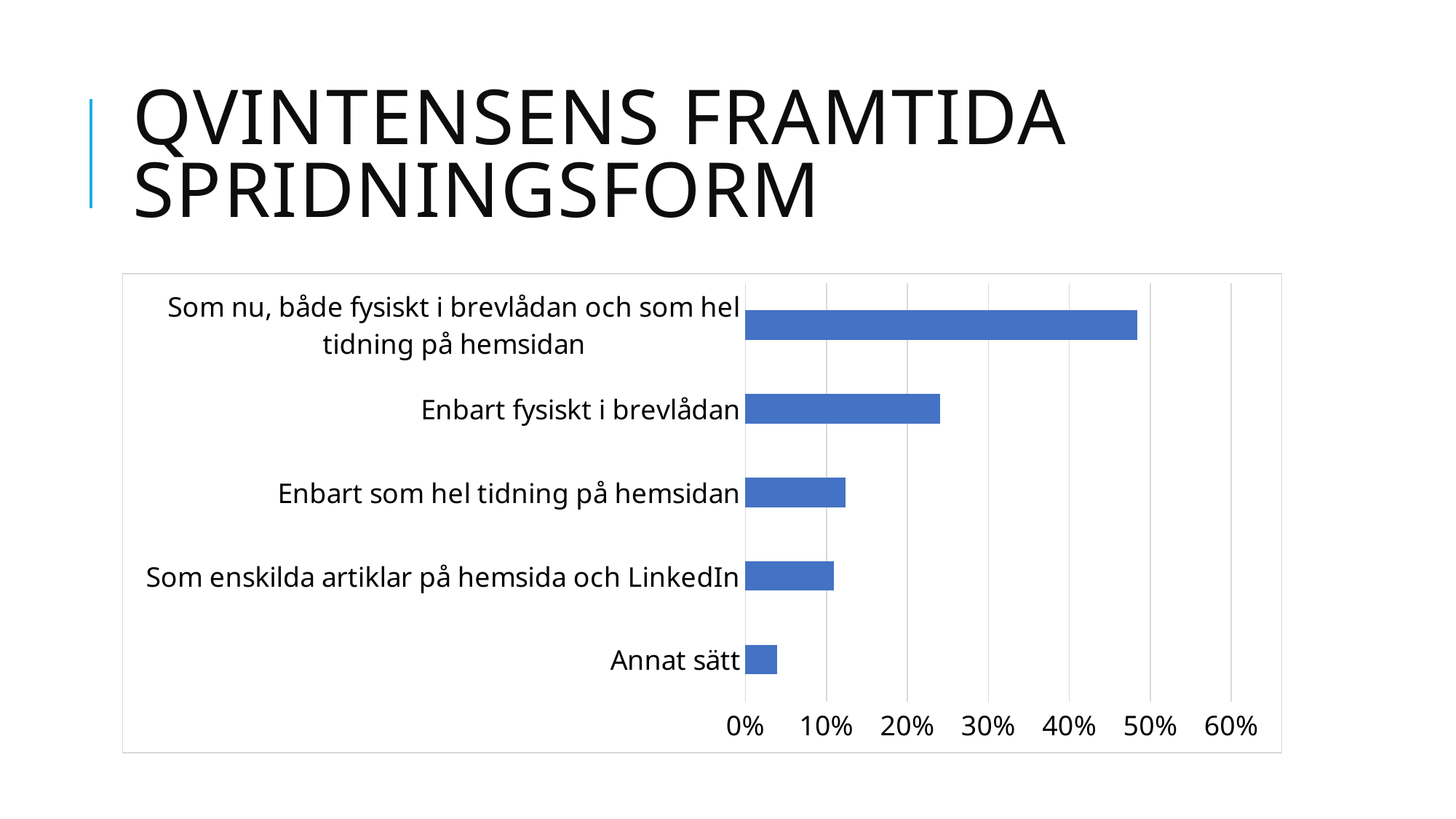
How many categories are shown in the chart? 5 What is the title of the slide? QVINTENSENS FRAMTIDA SPRIDNINGSFORM Is the value for "Enbart fysiskt i brevlådan" greater or less than 20%? greater Which is larger, the value for "Annat sätt" or the value for "Som enskilda artiklar på hemsida och LinkedIn"? Som enskilda artiklar på hemsida och LinkedIn Is the value for "Som enskilda artiklar på hemsida och LinkedIn" greater or less than 20%? less Is the value for "Som nu, både fysiskt i brevlådan och som hel tidning på hemsidan" greater or less than 40%? greater Which is larger, the value for "Enbart fysiskt i brevlådan" or the value for "Enbart som hel tidning på hemsidan"? Enbart fysiskt i brevlådan Which category has the lowest value? Annat sätt What kind of chart is shown on the slide? bar chart Which category has the highest value? Som nu, både fysiskt i brevlådan och som hel tidning på hemsidan